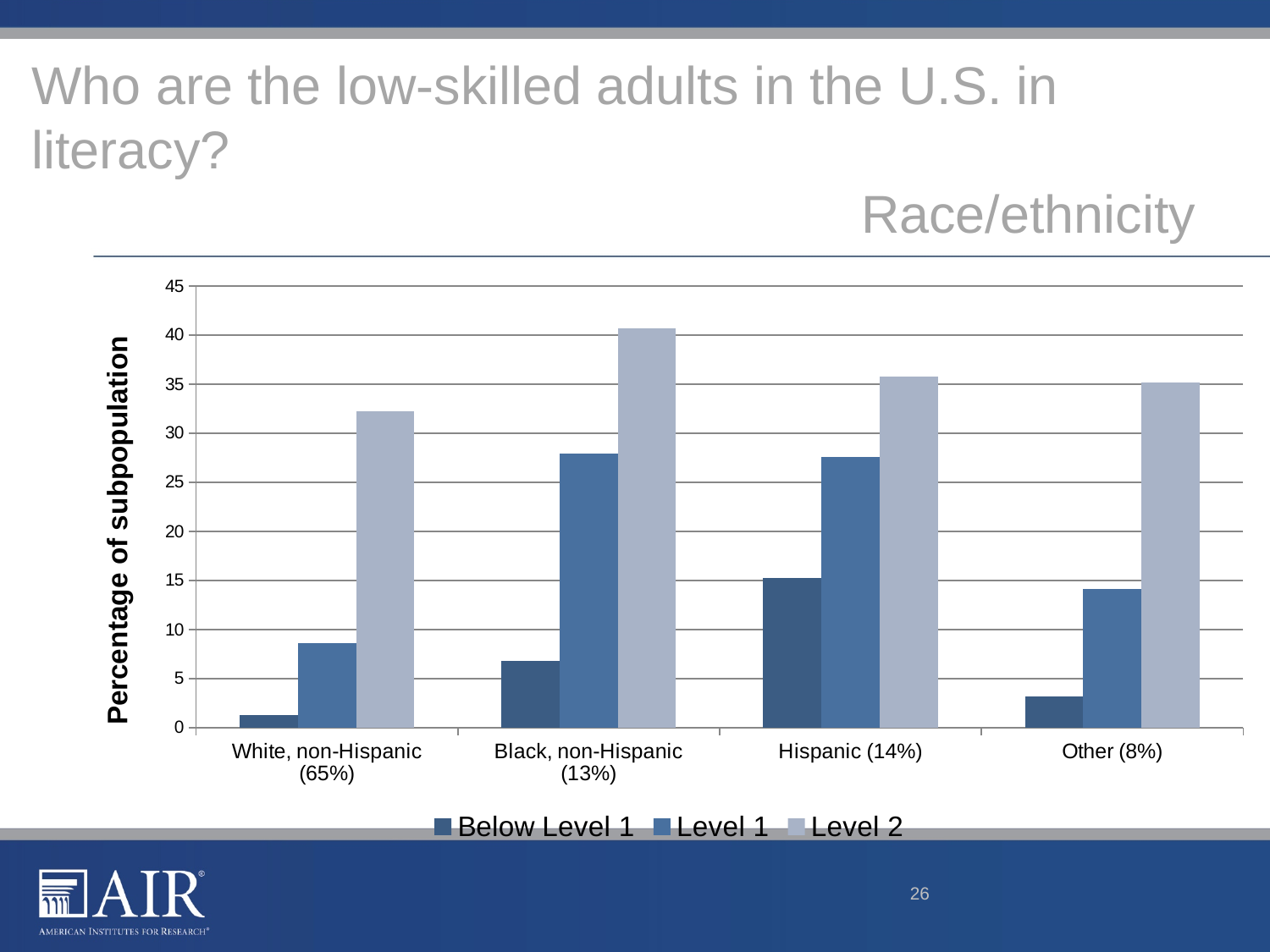
Which race/ethnicity group has the lowest Below Level 1 value? White, non-Hispanic (65%) What kind of chart is shown on the slide? bar chart Which is larger, the Level 2 value for Black, non-Hispanic (13%) or for White, non-Hispanic (65%)? Black, non-Hispanic (13%) How many series does the legend list? 3 Which race/ethnicity group has the highest Below Level 1 value? Hispanic (14%) How many race/ethnicity categories are shown on the x axis? 4 Is the Below Level 1 value for White, non-Hispanic (65%) greater or less than 5? less What is the label of the y axis? Percentage of subpopulation Which race/ethnicity group has the highest Level 2 value? Black, non-Hispanic (13%) Is the Below Level 1 value for Hispanic (14%) greater or less than 10? greater Is the Level 2 value for Black, non-Hispanic (13%) greater or less than 35? greater Which race/ethnicity group has the lowest Level 2 value? White, non-Hispanic (65%)